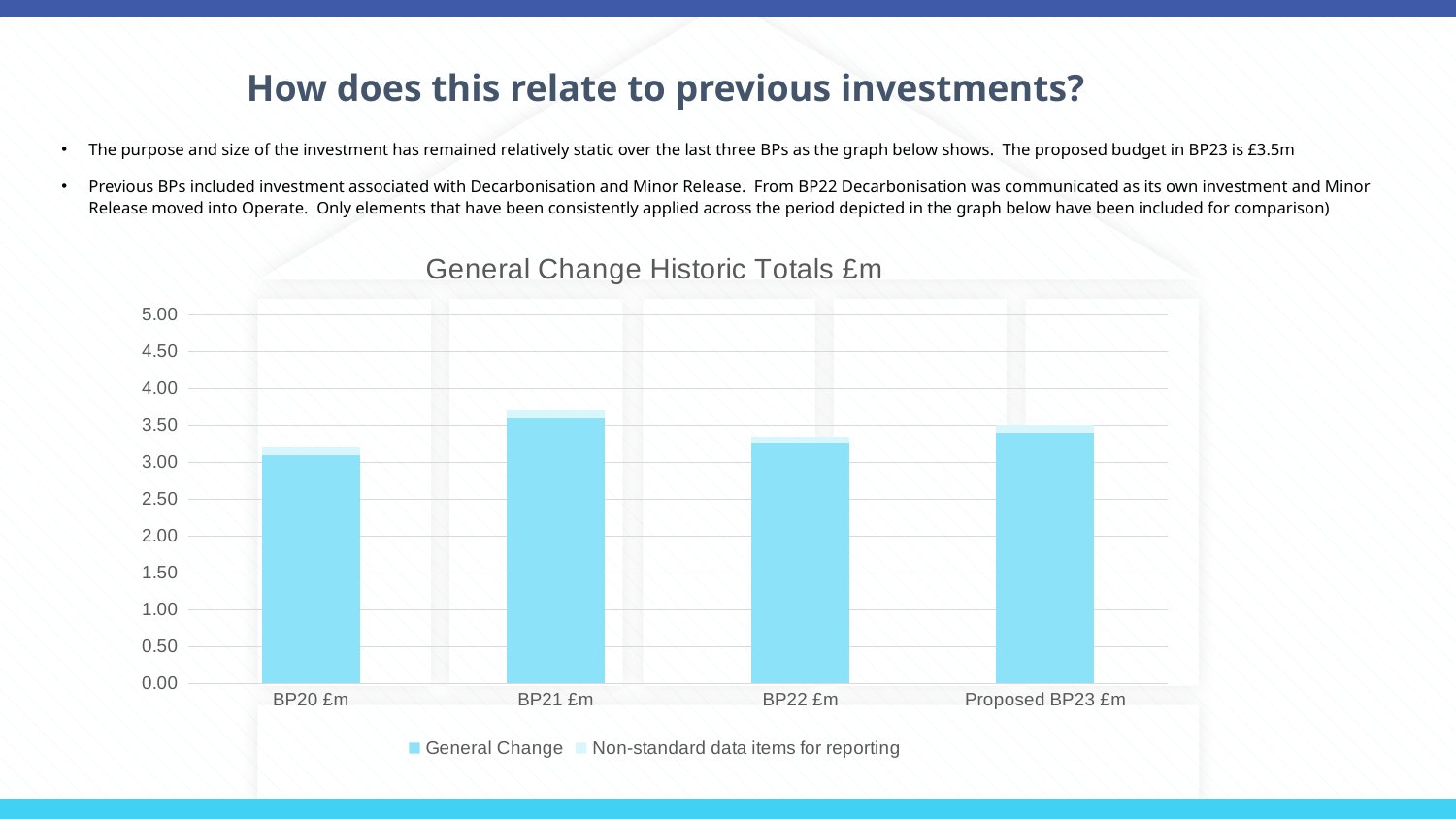
Which has the larger total stacked bar, BP21 £m or BP22 £m? BP21 £m Is the General Change value for BP20 £m greater or less than 3.00? greater Which category has the tallest stacked bar in the chart? BP21 £m Which category has the shortest stacked bar in the chart? BP20 £m What kind of chart is shown on the slide? Stacked bar chart Is the total stacked bar for BP20 £m greater or less than 3.50? less What is the title of the chart? General Change Historic Totals £m Is the total stacked bar for BP21 £m greater or less than 3.50? greater How many series does the chart's legend list? 2 Which series are listed in the chart's legend? General Change; Non-standard data items for reporting How many categories are shown on the x axis of the chart? 4